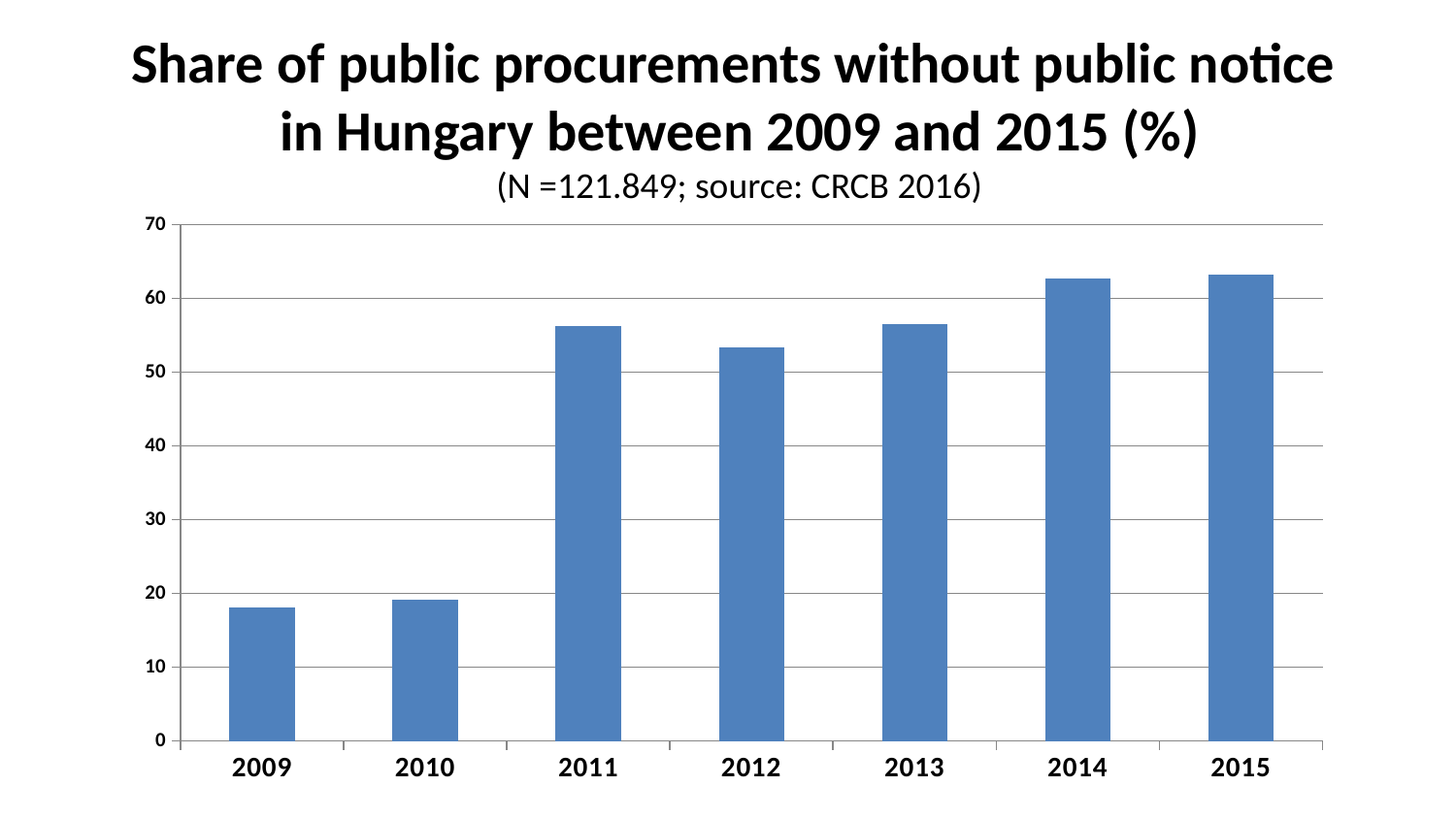
Which year has the larger value, 2013 or 2014? 2014 What is the sample size (N) stated in the chart subtitle? 121.849 How many years are shown on the x axis of the chart? 7 What kind of chart is shown on the slide? bar chart Is the value for 2012 greater or less than 50? greater Is the value for 2013 greater or less than 60? less Which year has the larger value, 2011 or 2012? 2011 Is the value for 2011 greater or less than 50? greater Which year has the larger value, 2010 or 2011? 2011 Do the values generally rise or fall from 2009 to 2015? rise